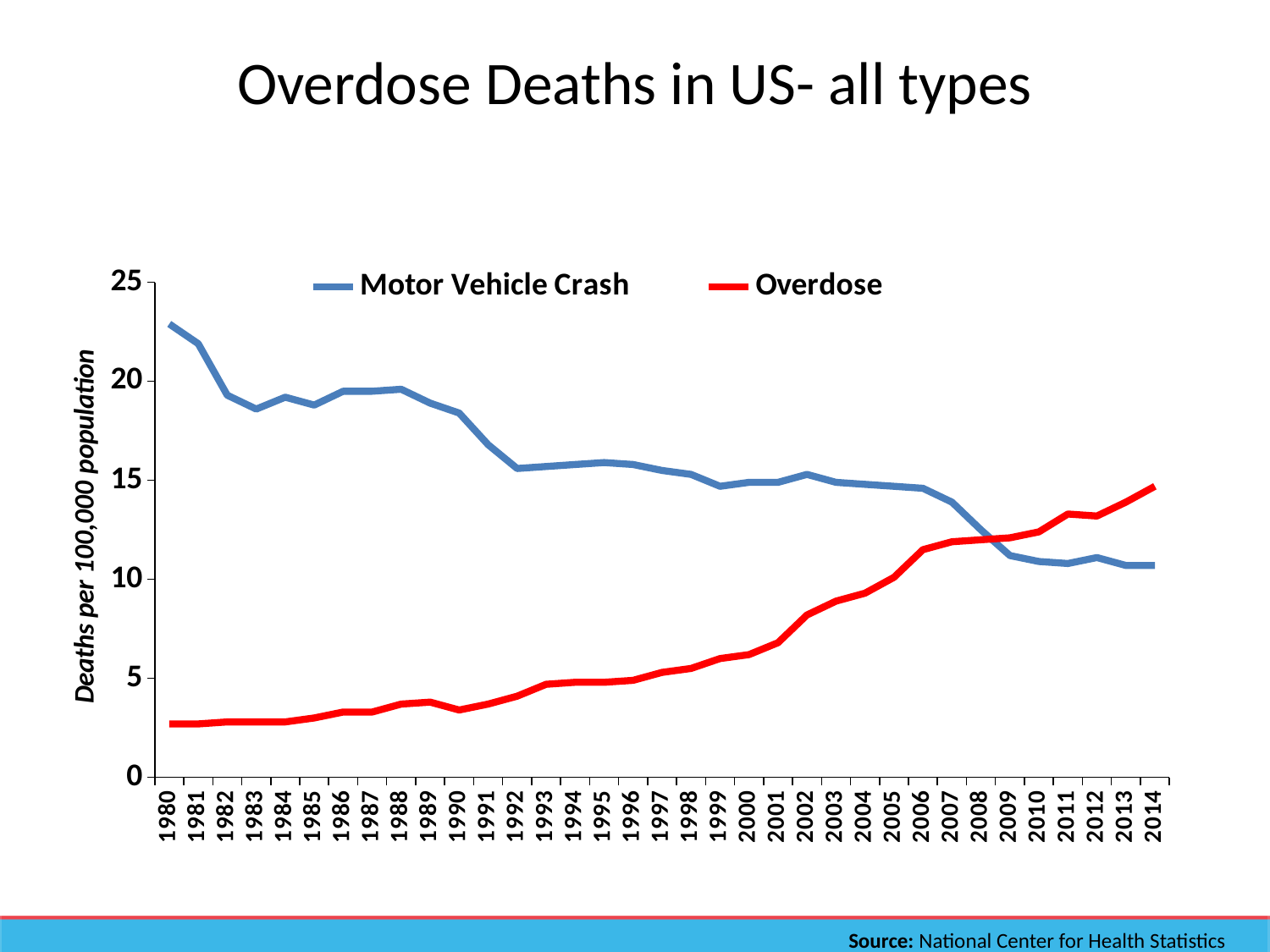
Is the Motor Vehicle Crash value for 1980 greater or less than 20? greater Is the Motor Vehicle Crash value for 2014 greater or less than 15? less In 1990, which series has the higher value, Motor Vehicle Crash or Overdose? Motor Vehicle Crash What is the label on the y axis? Deaths per 100,000 population In 2014, which series has the higher value, Motor Vehicle Crash or Overdose? Overdose How many series does the legend list? 2 What kind of chart is shown on the slide? Line chart Does the Overdose line rise or fall from 1980 to 2014? Rises How many years are plotted along the x axis? 35 In which year is the Overdose value highest? 2014 Is the Overdose value for 1980 greater or less than 5? less Does the Motor Vehicle Crash line rise or fall from 1980 to 2014? Falls